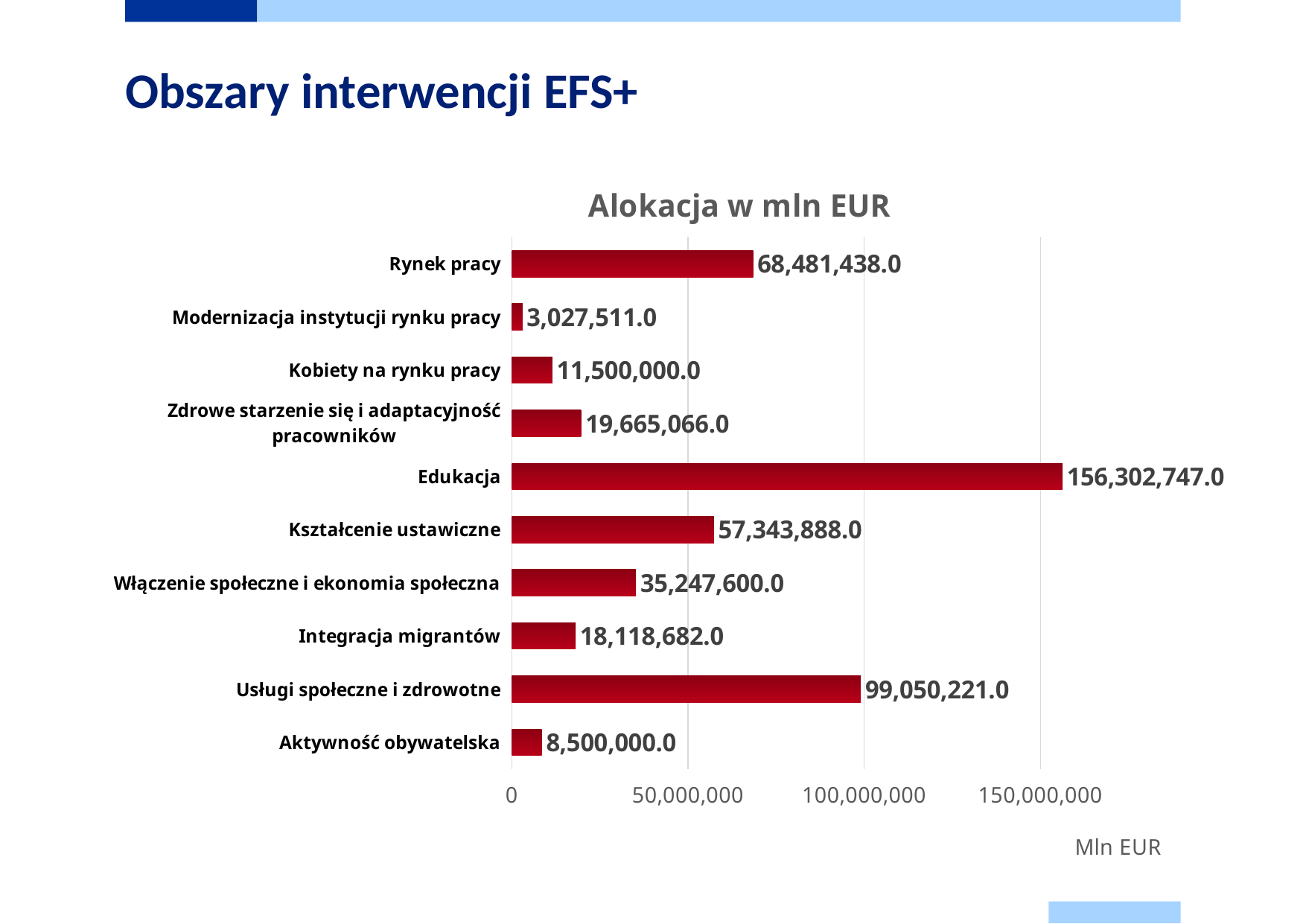
Which is larger, the value for Włączenie społeczne i ekonomia społeczna or the value for Zdrowe starzenie się i adaptacyjność pracowników? Włączenie społeczne i ekonomia społeczna Which category has the lowest value? Modernizacja instytucji rynku pracy What is the value for Edukacja? 156,302,747.0 What is the value for Usługi społeczne i zdrowotne? 99,050,221.0 What is the difference between the values for Kobiety na rynku pracy and Aktywność obywatelska? 3,000,000.0 How many categories are shown in the chart? 10 Is the value for Usługi społeczne i zdrowotne greater or less than 100,000,000? less What kind of chart is shown on the slide? bar chart What is the title of the chart? Alokacja w mln EUR Which category has the highest value? Edukacja What is the difference between the values for Rynek pracy and Kształcenie ustawiczne? 11,137,550.0 What is the value for Integracja migrantów? 18,118,682.0